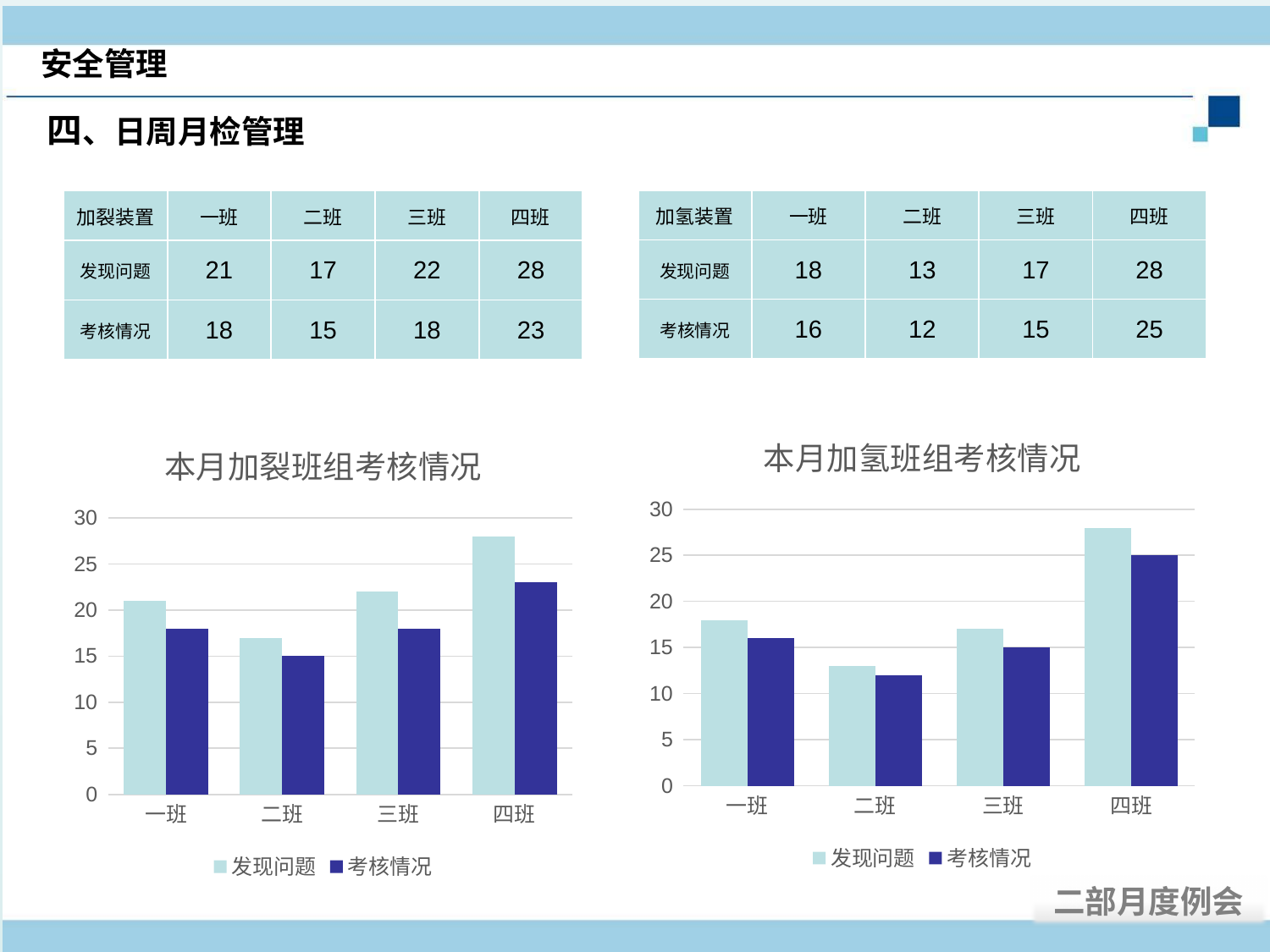
In the chart titled 本月加氢班组考核情况, what is the difference between the 发现问题 and 考核情况 values for 一班? 2 In the chart titled 本月加裂班组考核情况, how many categories are shown on the x axis? 4 In the chart titled 本月加裂班组考核情况, how many series does the legend list? 2 In the chart titled 本月加裂班组考核情况, which category has the highest 发现问题 value? 四班 In the chart titled 本月加裂班组考核情况, is the 发现问题 value for 四班 greater or less than 25? greater In the chart titled 本月加氢班组考核情况, which category has the lowest 发现问题 value? 二班 In the chart titled 本月加裂班组考核情况, what is the 发现问题 value for 三班? 22 In the chart titled 本月加氢班组考核情况, which is larger for 三班, 发现问题 or 考核情况? 发现问题 In the chart titled 本月加氢班组考核情况, what is the 考核情况 value for 四班? 25 In the chart titled 本月加裂班组考核情况, what kind of chart is shown? bar chart In the chart titled 本月加裂班组考核情况, which category has the lowest 考核情况 value? 二班 In the chart titled 本月加氢班组考核情况, is the 考核情况 value for 二班 greater or less than 15? less